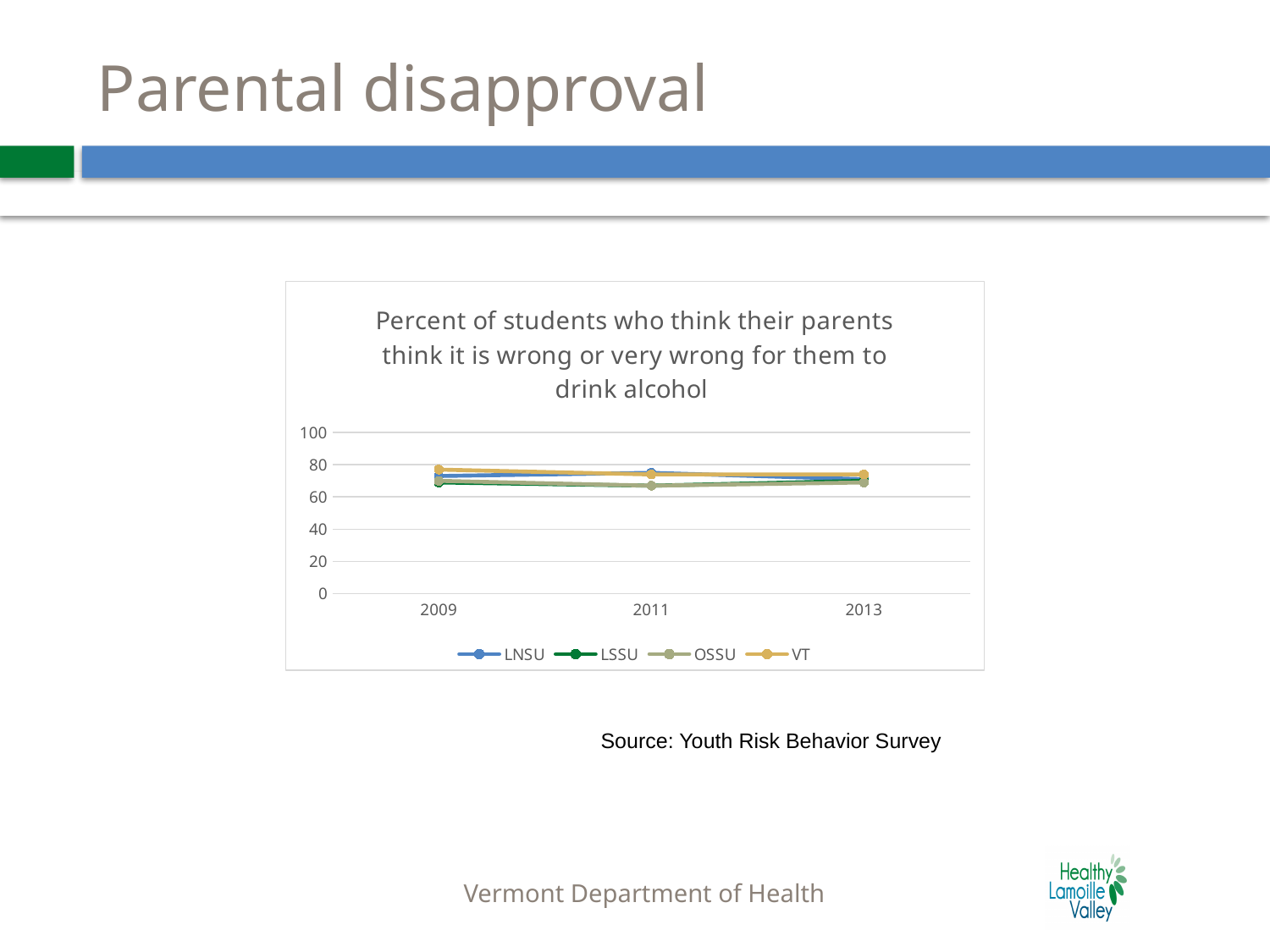
How many series does the legend list? 4 Is the value for OSSU in 2009 greater or less than 20? greater Is the value for LNSU in 2013 greater or less than 80? less How many years are shown on the x axis? 3 Is the value for VT in 2009 greater or less than 40? greater Which series are listed in the legend? LNSU, LSSU, OSSU, VT What kind of chart is shown on the slide? line chart What is the title of the chart? Percent of students who think their parents think it is wrong or very wrong for them to drink alcohol Does the VT line rise or fall from 2009 to 2013? fall What is the first year shown on the x axis? 2009